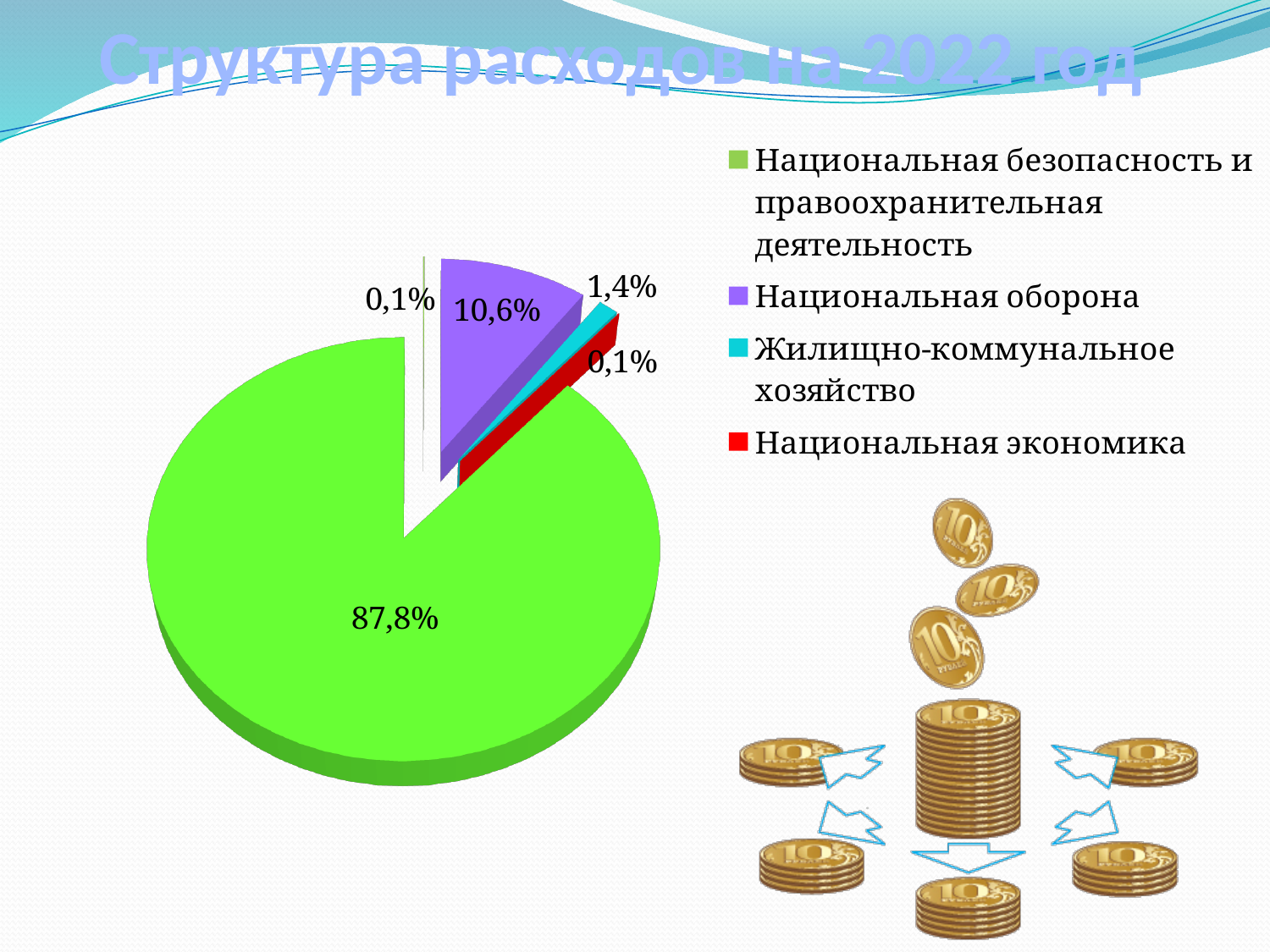
How many entries does the legend list? 4 What colour is the slice for Национальная оборона? Purple What kind of chart is shown on the slide? Pie chart What is the title of the chart? Структура расходов на 2022 год What percentage is shown for Национальная оборона? 10,6%